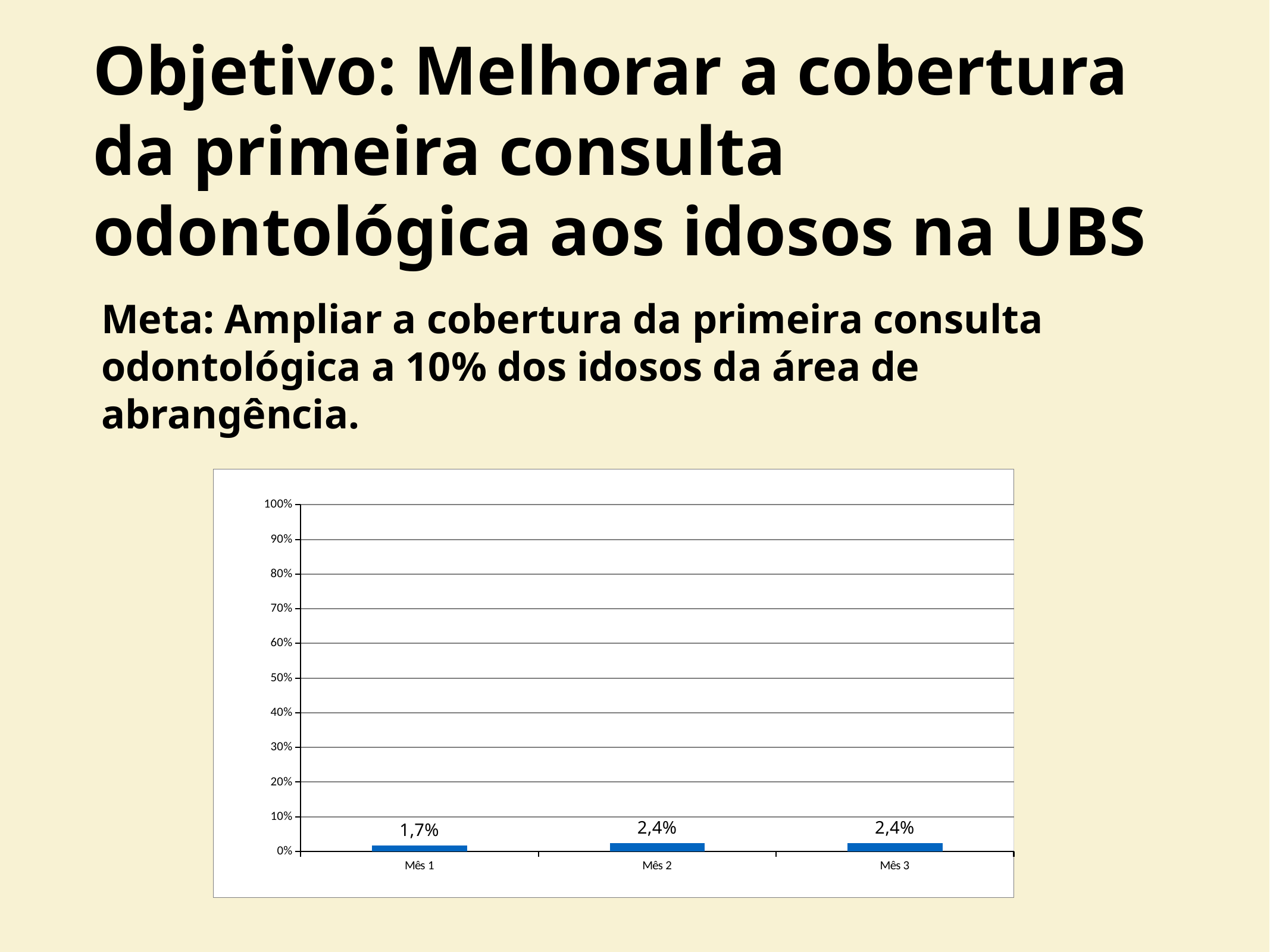
What is the value for Mês 2? 2,4% What is the value for Mês 3? 2,4% How many months are shown on the x axis? 3 What is the difference between the values for Mês 2 and Mês 1? 0,7% What colour are the bars in the chart? blue Which is larger, the value for Mês 1 or the value for Mês 3? Mês 3 What is the value for Mês 1? 1,7% What is the highest value shown on the y axis? 100% Is the value for Mês 2 greater or less than 10%? less Do the values rise or fall from Mês 1 to Mês 2? rise What kind of chart is shown on the slide? bar chart Which month has the lowest value? Mês 1